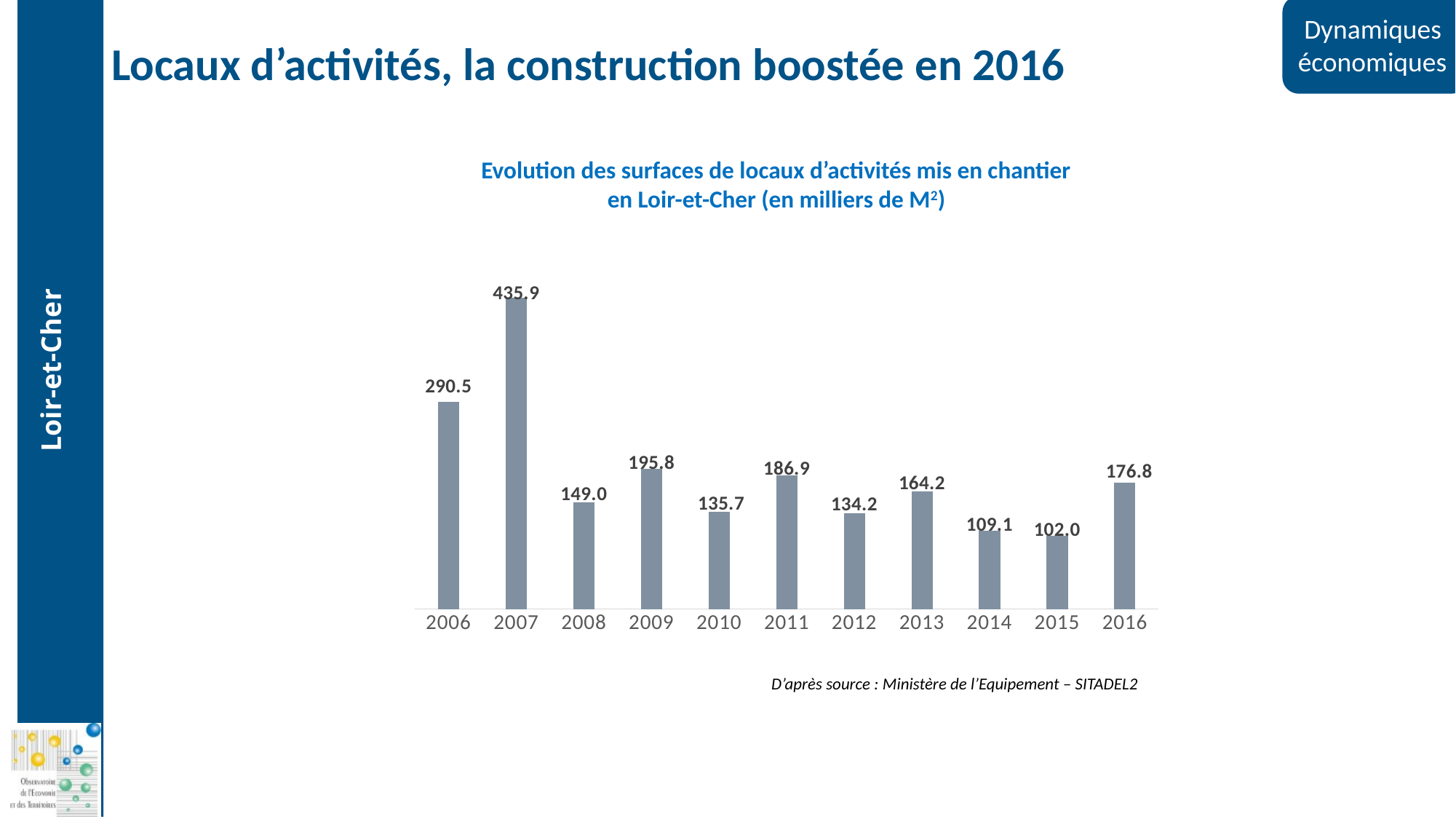
What is the value for 2007? 435.9 What is the value for 2012? 134.2 Which year has the lowest value? 2015 What is the value for 2016? 176.8 How many years are shown on the x axis? 11 What is the difference between the values for 2007 and 2006? 145.4 What kind of chart is shown on the slide? Bar chart Which is larger, the value for 2013 or the value for 2014? 2013 What is the difference between the values for 2016 and 2015? 74.8 Which is larger, the value for 2009 or the value for 2011? 2009 Which year has the highest value? 2007 What is the title of the chart? Evolution des surfaces de locaux d'activités mis en chantier en Loir-et-Cher (en milliers de M²)